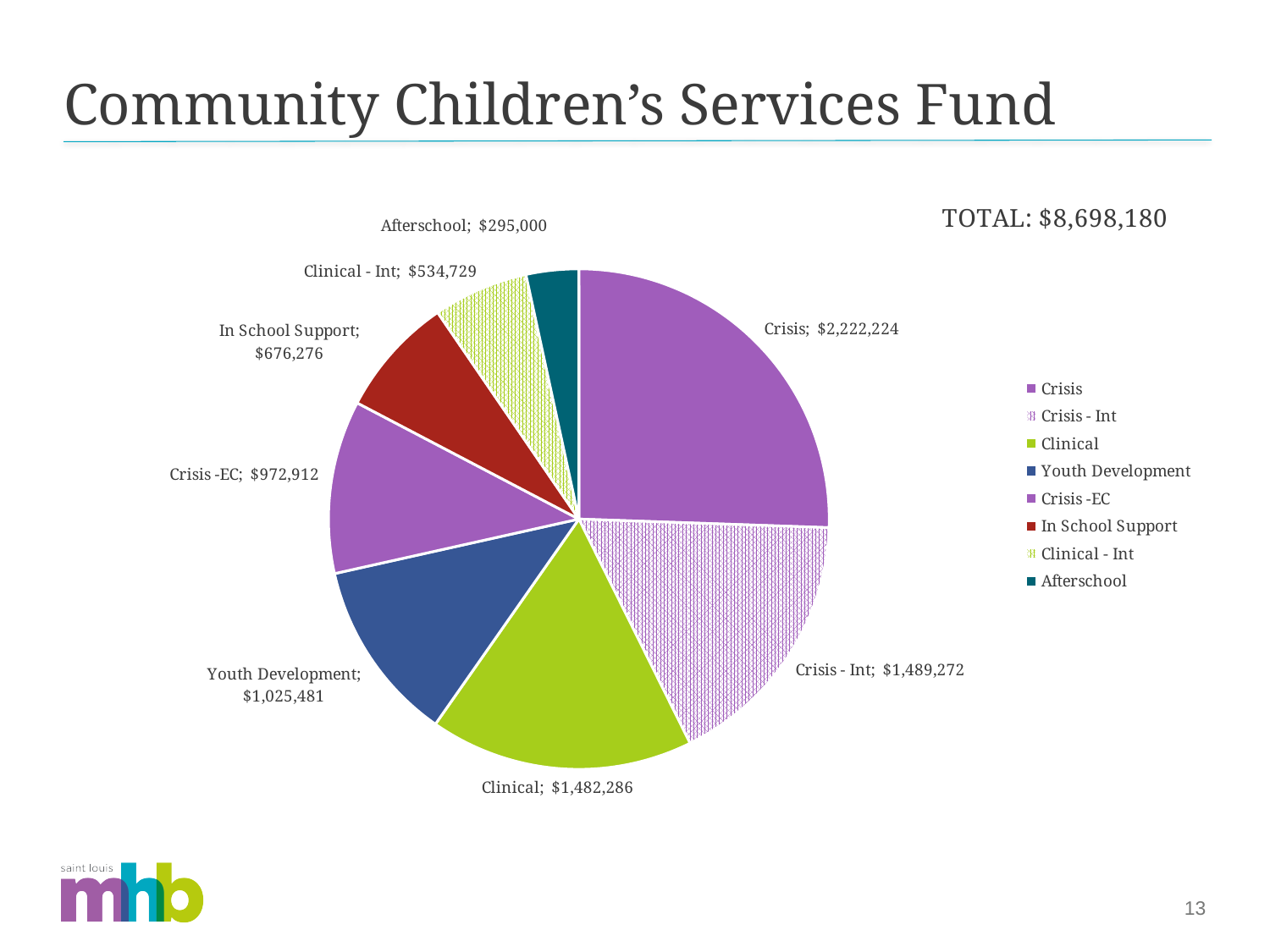
What total amount is stated on the slide for the Community Children's Services Fund? $8,698,180 Which category has the smallest slice of the pie chart? Afterschool How many categories are shown in the pie chart? 8 What is the value for In School Support in the pie chart? $676,276 What is the difference between the In School Support value and the Clinical - Int value? $141,547 What is the value for Crisis in the pie chart? $2,222,224 What is the value for Youth Development in the pie chart? $1,025,481 Which is larger, Youth Development or Crisis -EC? Youth Development What type of chart is shown on the slide? Pie chart Which category has the largest slice of the pie chart? Crisis What is the value for Afterschool in the pie chart? $295,000 What is the difference between the Crisis value and the Afterschool value? $1,927,224